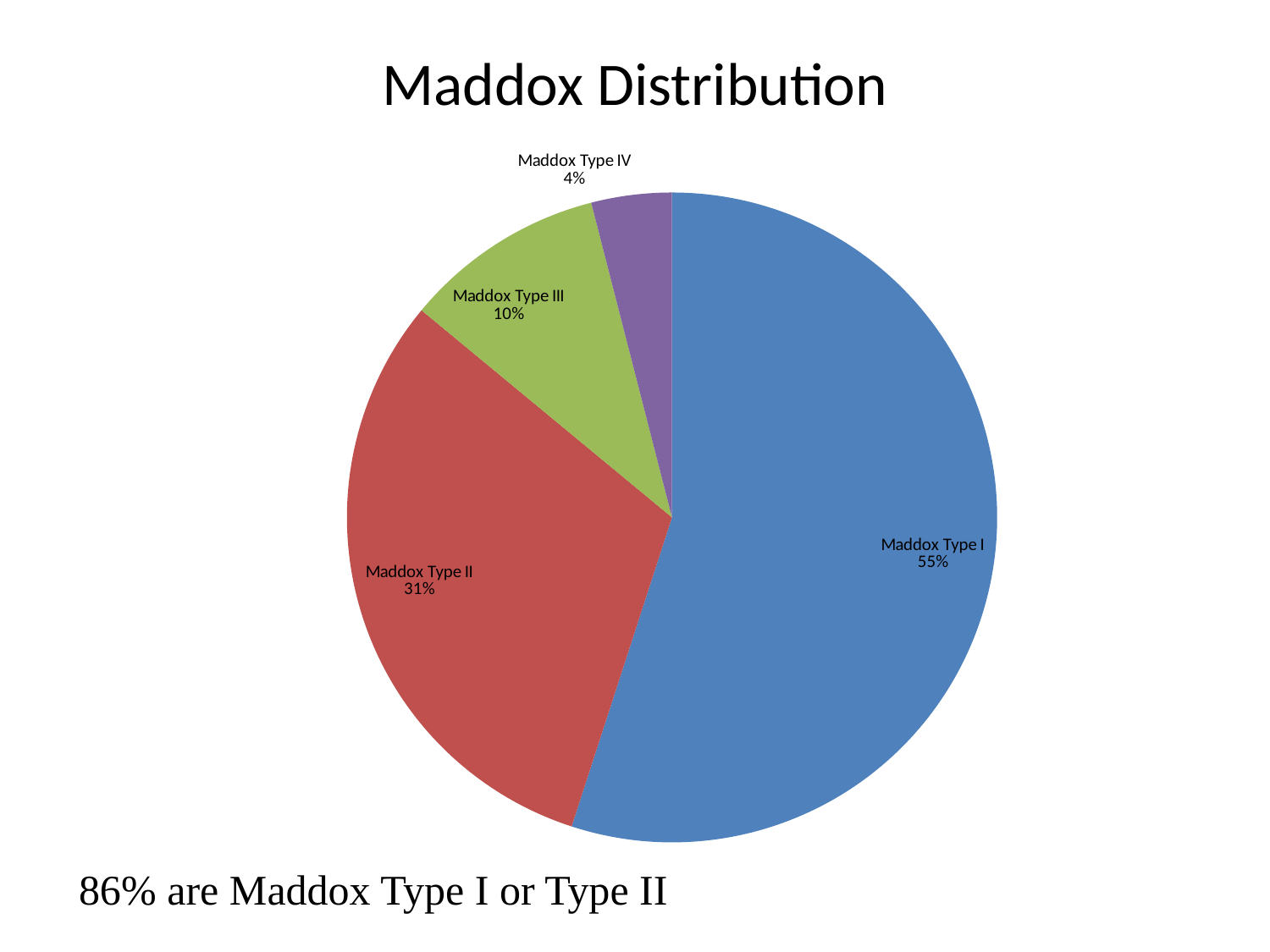
What share of the pie is Maddox Type II? 31% What kind of chart is shown on the slide? pie chart What share of the pie is Maddox Type IV? 4% Which category has the largest slice of the pie? Maddox Type I What share of the pie is Maddox Type III? 10% What is the difference in percentage points between Maddox Type I and Maddox Type II? 24 What colour is the slice for Maddox Type II? red Which category has the smallest slice of the pie? Maddox Type IV How many slices does the pie chart have? 4 Which is larger, the share for Maddox Type III or the share for Maddox Type IV? Maddox Type III What is the title of the chart? Maddox Distribution